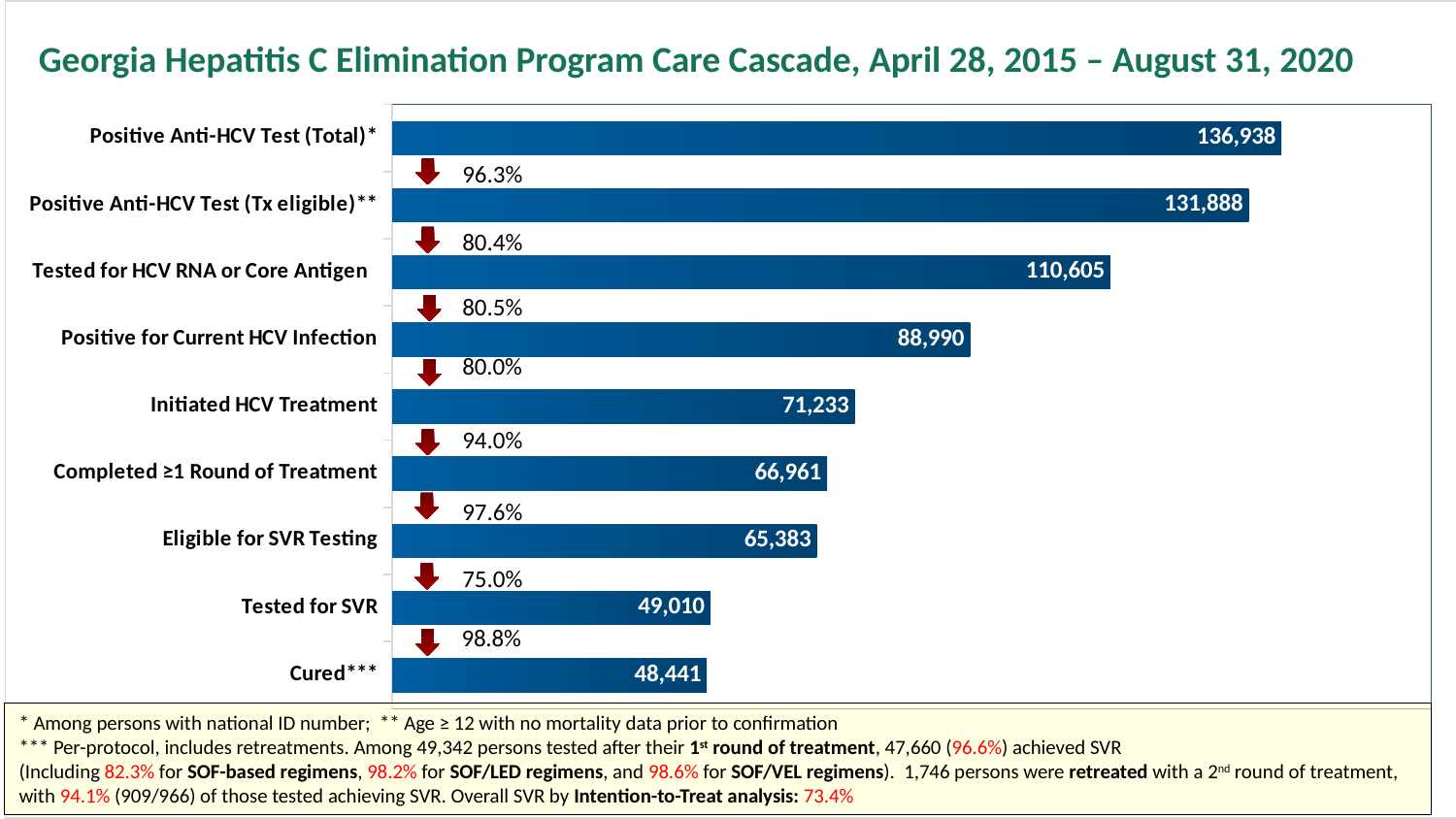
What percentage is shown between Tested for SVR and Cured? 98.8% Which category has the lowest value? Cured Which category has the highest value? Positive Anti-HCV Test (Total) What kind of chart is shown on the slide? Bar chart Which is larger, Positive for Current HCV Infection or Eligible for SVR Testing? Positive for Current HCV Infection What is the value for Positive Anti-HCV Test (Total)? 136,938 What is the difference between Initiated HCV Treatment and Completed ≥1 Round of Treatment? 4,272 What is the value for Cured? 48,441 How many categories are shown in the chart? 9 What is the value for Tested for HCV RNA or Core Antigen? 110,605 What is the difference between Positive Anti-HCV Test (Total) and Cured? 88,497 What is the value for Initiated HCV Treatment? 71,233